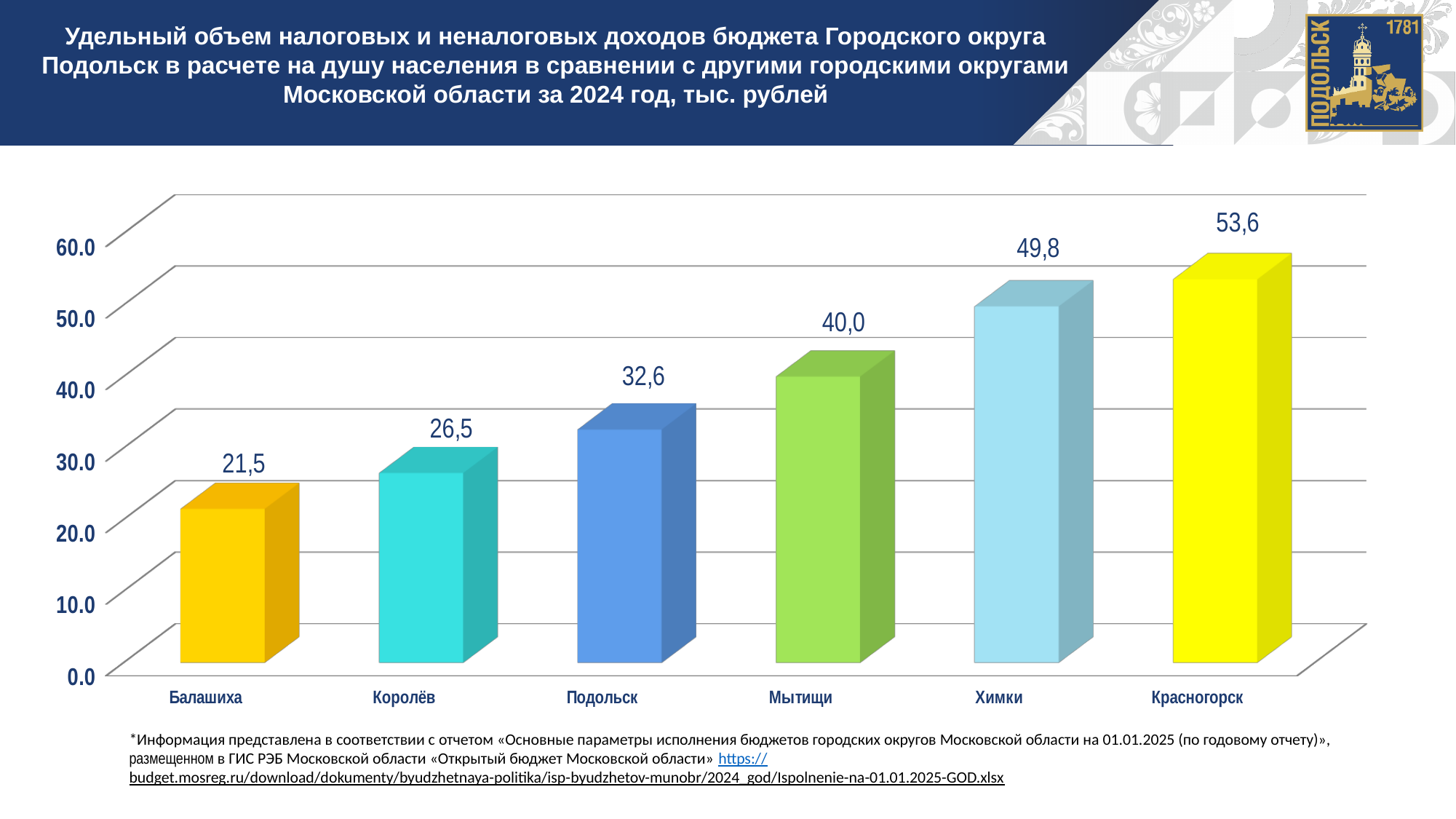
What kind of chart is shown on the slide? bar chart What is the difference between the values for Красногорск and Подольск? 21,0 Is the value for Королёв greater or less than 30.0? less Which city has the highest value? Красногорск What is the difference between the values for Мытищи and Королёв? 13,5 What is the value for Балашиха? 21,5 Which city has the lowest value? Балашиха How many cities are shown on the chart? 6 Which is larger, the value for Мытищи or the value for Химки? Химки Do the values rise or fall from left to right along the x axis? rise What is the value for Химки? 49,8 What is the value for Подольск? 32,6